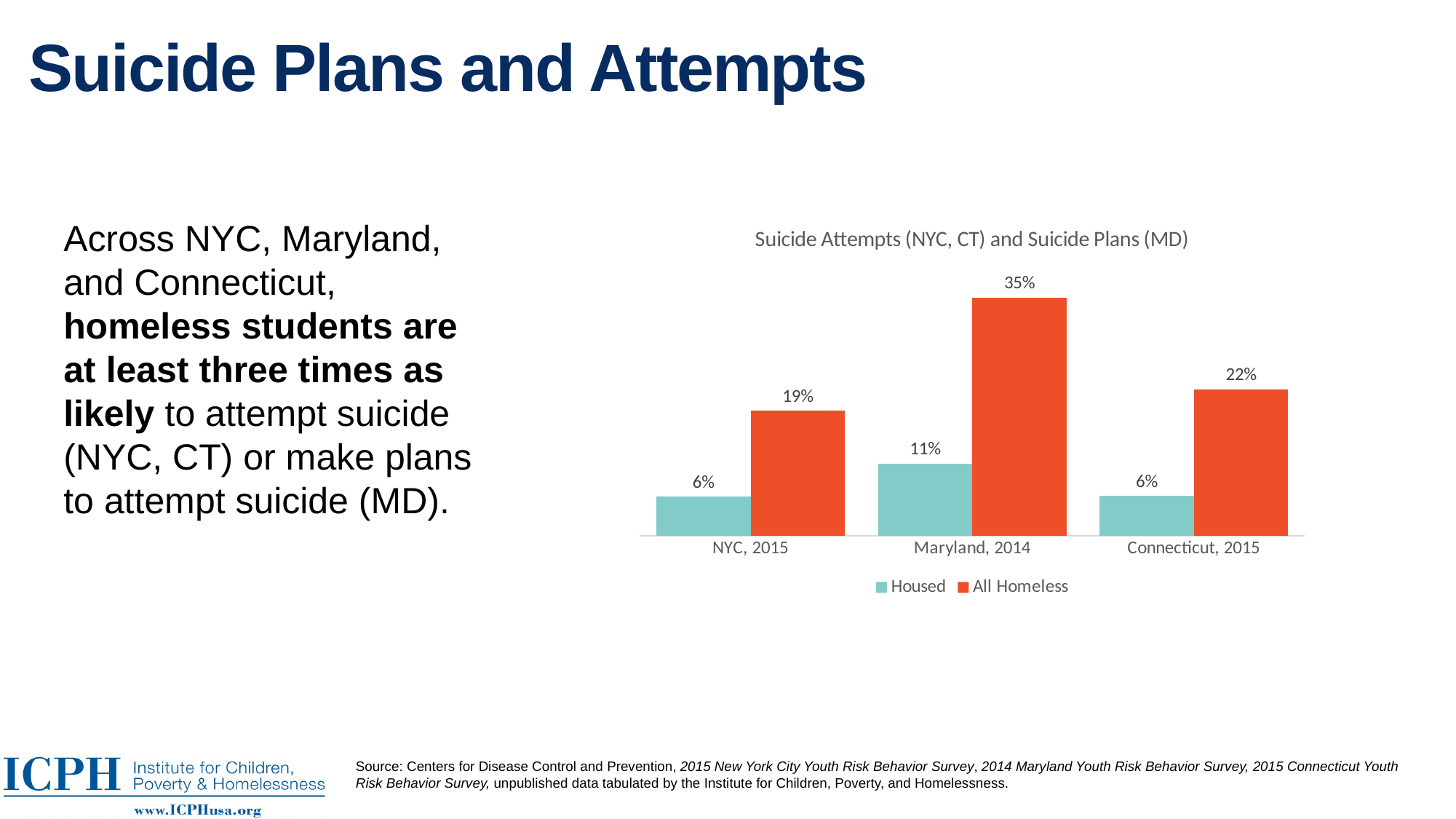
What is the value for Housed in NYC, 2015? 6% What is the value for Housed in Maryland, 2014? 11% Which category has the lowest All Homeless value? NYC, 2015 How many categories are shown on the x axis? 3 What is the difference between the All Homeless values for Connecticut, 2015 and NYC, 2015? 3% What is the difference between the All Homeless and Housed values for Maryland, 2014? 24% Which category has the highest All Homeless value? Maryland, 2014 Which is larger: the All Homeless value for NYC, 2015 or the Housed value for Maryland, 2014? All Homeless value for NYC, 2015 What is the value for All Homeless in Connecticut, 2015? 22% What kind of chart is shown on the slide? Bar chart What is the value for All Homeless in Maryland, 2014? 35% How many series does the legend list? 2